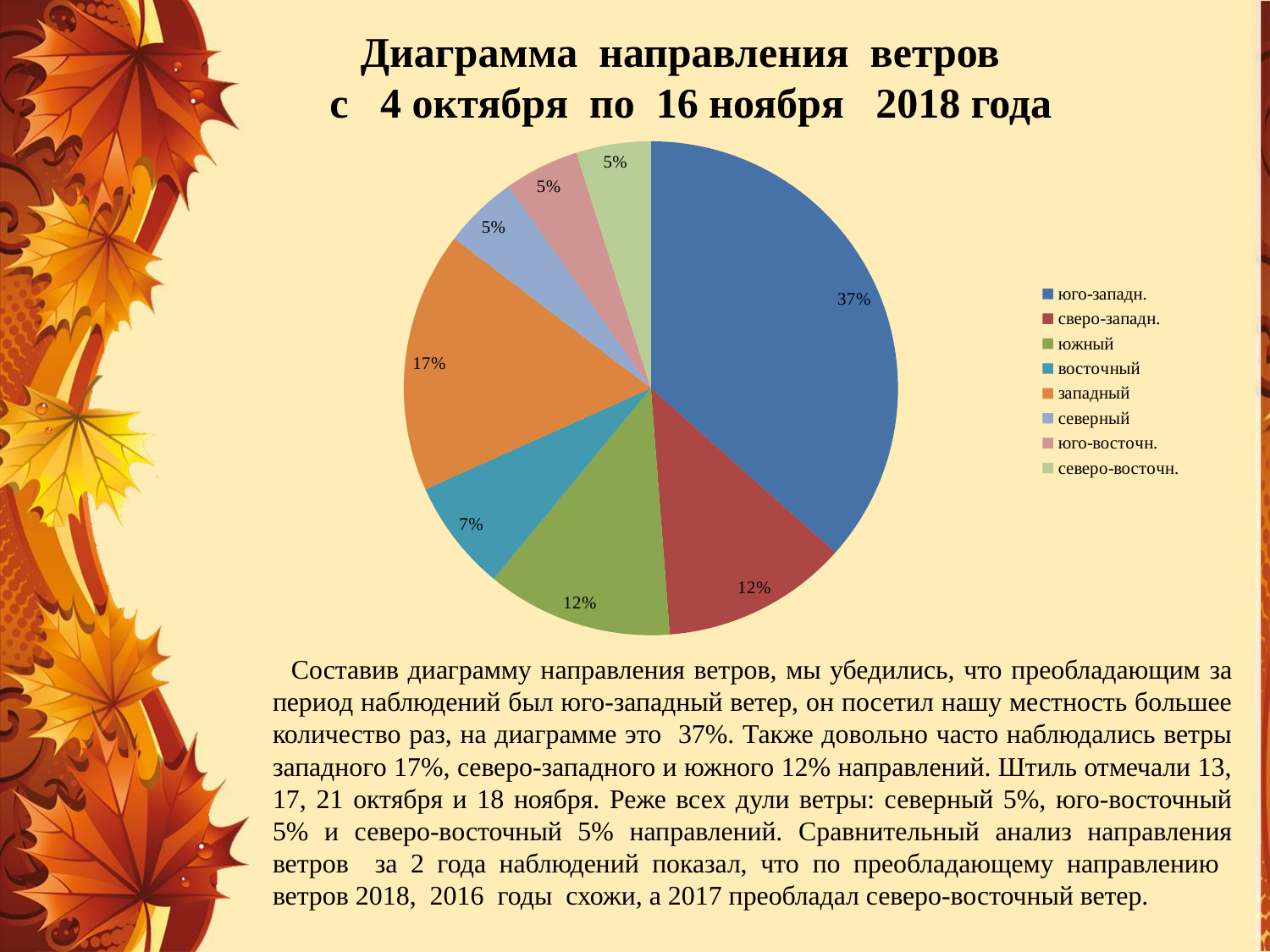
What is the title of the chart on the slide? Диаграмма направления ветров с 4 октября по 16 ноября 2018 года What is the difference between the юго-западн. slice and the западный slice? 20% What kind of chart is shown on the slide? pie chart Which wind direction has the largest slice of the pie? юго-западн. What is the value shown for the западный slice? 17% How many slices does the pie chart have? 8 What is the value shown for the северный slice? 5% Which slice is larger, западный or южный? западный What is the value shown for the восточный slice? 7% What is the difference between the западный slice and the восточный slice? 10% What percentage of the pie does the юго-западн. slice represent? 37% How many entries does the legend list? 8